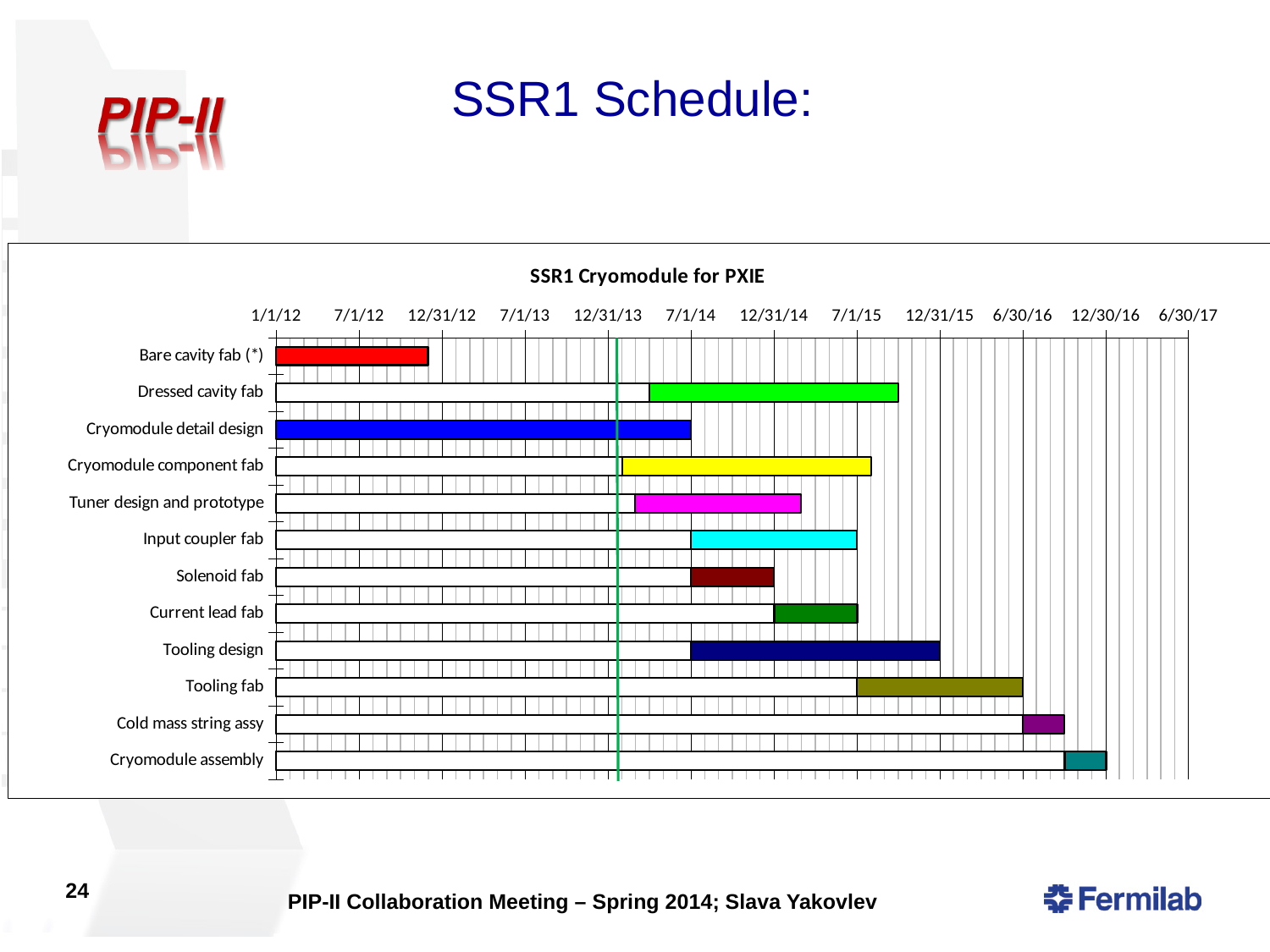
What is the title of the chart? SSR1 Cryomodule for PXIE Which task finishes last on the chart? Cryomodule assembly What colour is the bar for Bare cavity fab (*)? Red How many tasks are listed on the chart? 12 Does the Cold mass string assy bar start before or after 12/31/15? after Which task has the longest bar on the chart? Cryomodule detail design Which task is listed first (at the top) of the chart? Bare cavity fab (*) What kind of chart is shown on the slide? Bar chart (Gantt chart) Does the Tuner design and prototype bar end before or after 7/1/15? before Does the Dressed cavity fab bar start before or after 7/1/14? before Which task starts earlier, Solenoid fab or Current lead fab? Solenoid fab